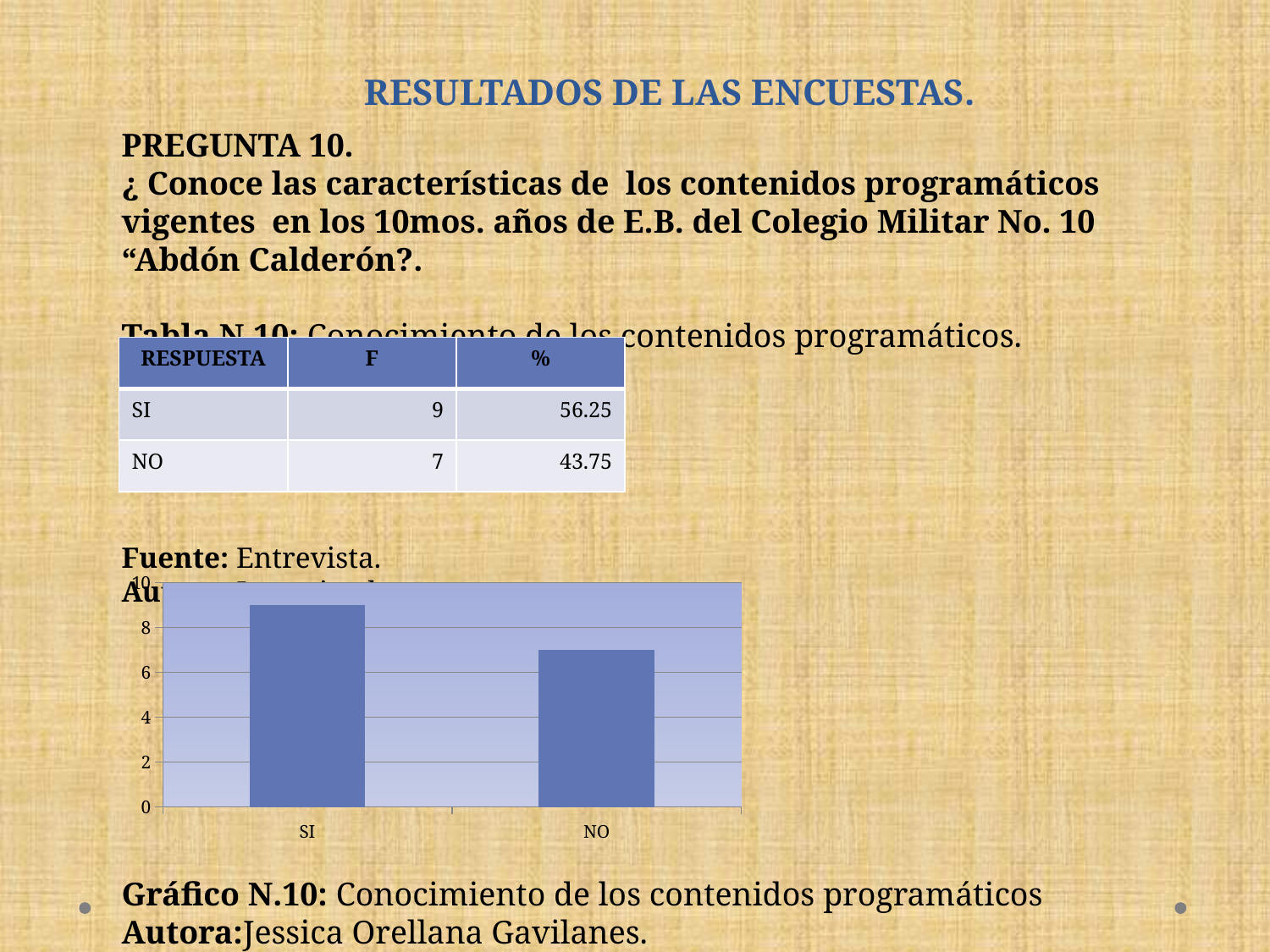
Is the bar for SI greater or less than 10? less Is the bar for NO greater or less than 8? less How many categories does the bar chart show? 2 Is the value for SI larger or smaller than the value for NO? larger What is the highest value shown on the chart's vertical axis? 10 Which category has the taller bar in the chart, SI or NO? SI Is the bar for SI greater or less than 8? greater Which category has the shorter bar in the chart? NO According to the table on the slide, what is the frequency (F) for NO? 7 What kind of chart is shown on the slide? bar chart According to the table on the slide, what is the frequency (F) for SI? 9